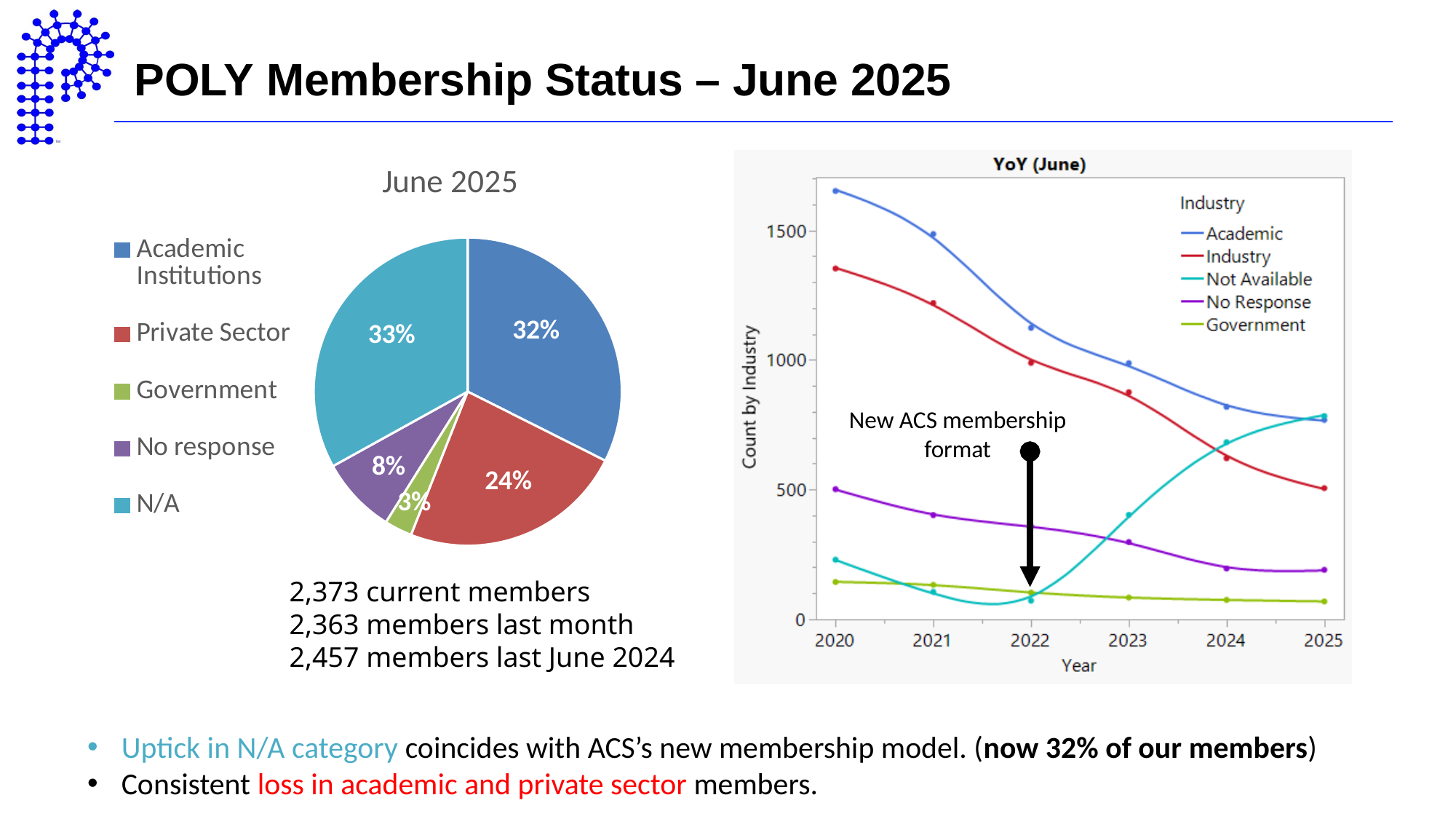
In the YoY (June) chart, does the Academic series rise or fall from 2020 to 2025? Fall In the June 2025 pie chart, what share of members is Academic Institutions? 32% How many categories does the June 2025 pie chart show? 5 In the YoY (June) chart, is the Academic value for 2020 greater or less than 1500? greater In the June 2025 pie chart, which category has the largest share? N/A What kind of chart is the YoY (June) chart? Line chart In the June 2025 pie chart, which category has the smallest share? Government How many series does the legend of the YoY (June) chart list? 5 In the June 2025 pie chart, what share of members is Government? 3% In the June 2025 pie chart, what is the difference between the N/A share and the No response share? 25% In the June 2025 pie chart, what share of members is Private Sector? 24% In the June 2025 pie chart, which is larger: Private Sector or No response? Private Sector